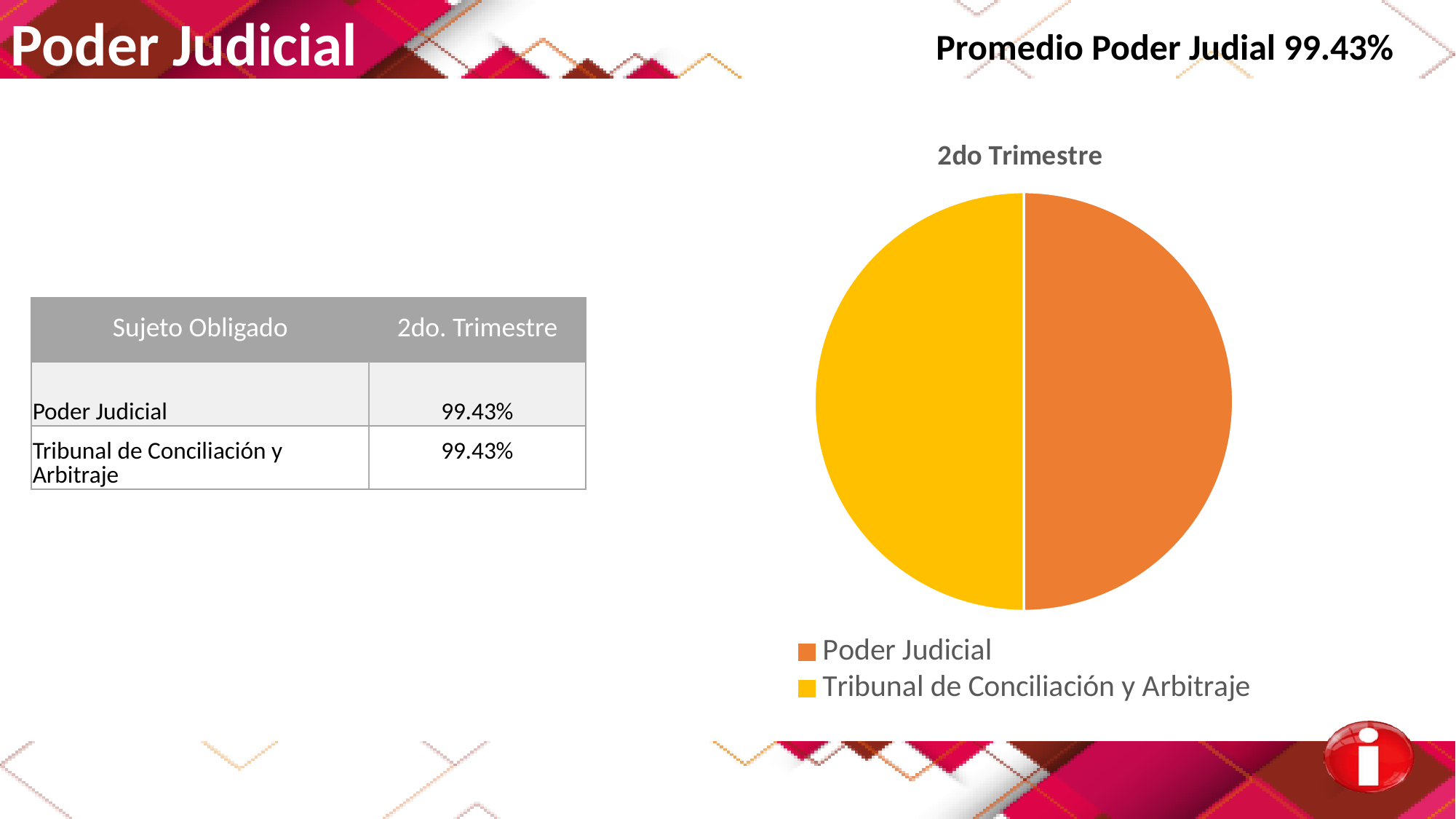
Which legend entry is listed second in the pie chart's legend? Tribunal de Conciliación y Arbitraje How many slices does the pie chart have? 2 What is the 2do. Trimestre value for Poder Judicial? 99.43% What is the difference between the 2do. Trimestre values for Poder Judicial and Tribunal de Conciliación y Arbitraje? 0% Which colour represents Poder Judicial in the pie chart? orange What kind of chart is shown on the slide? pie chart What is the title of the pie chart? 2do Trimestre What is the 2do. Trimestre value for Tribunal de Conciliación y Arbitraje? 99.43% How many entries does the legend of the pie chart list? 2